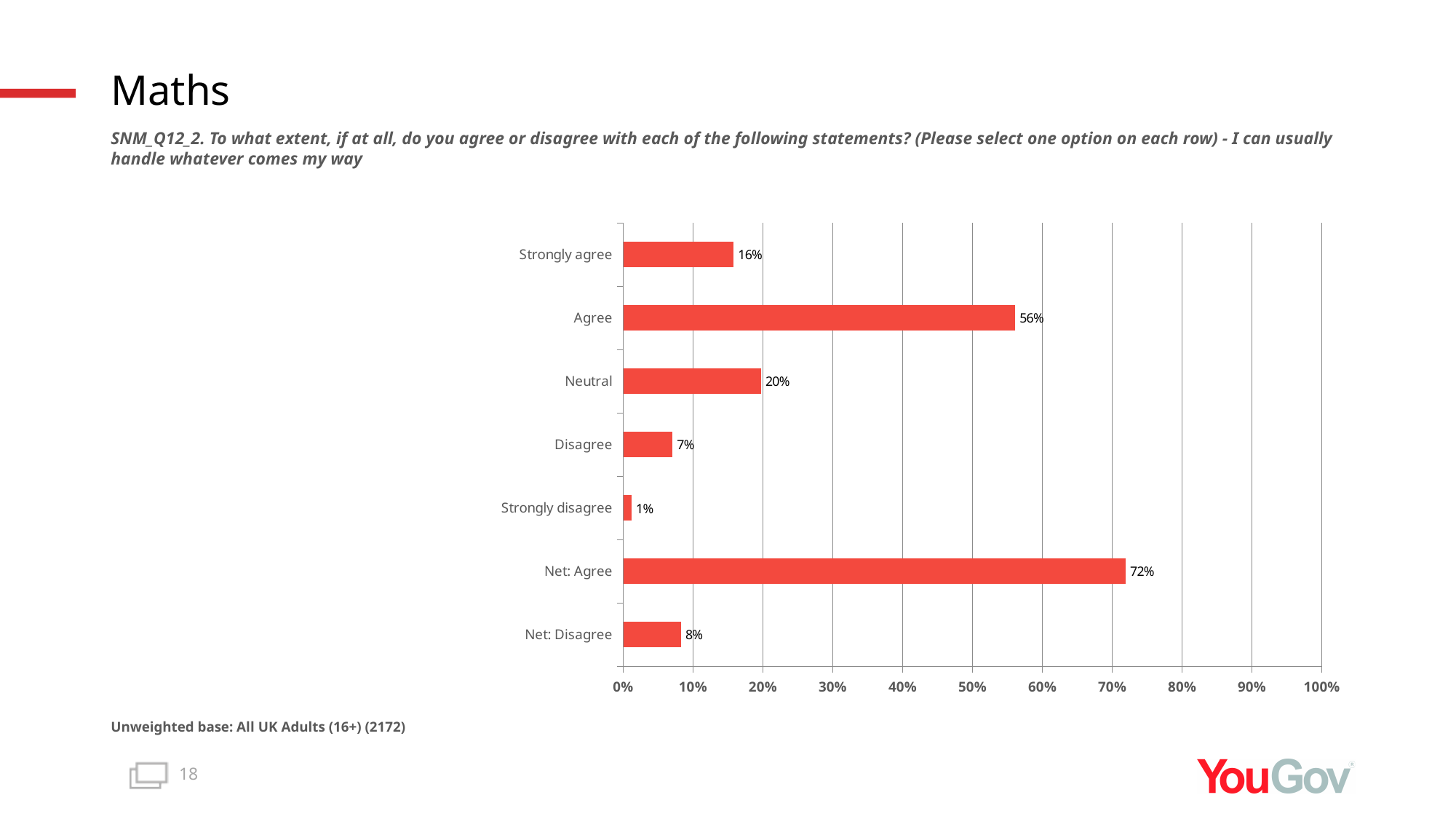
What is the unweighted base stated below the chart? All UK Adults (16+) (2172) What kind of chart is shown on the slide? Bar chart Which category has the lowest value? Strongly disagree What is the difference between 'Agree' and 'Strongly agree'? 40% Is the value for 'Net: Agree' greater or less than 70%? greater What is the value shown for 'Net: Agree'? 72% Which is larger, 'Neutral' or 'Disagree'? Neutral How many categories are shown on the chart? 7 What percentage of respondents selected 'Agree'? 56% What percentage of respondents selected 'Strongly disagree'? 1% What is the value shown for 'Neutral'? 20% Which category has the highest value? Net: Agree